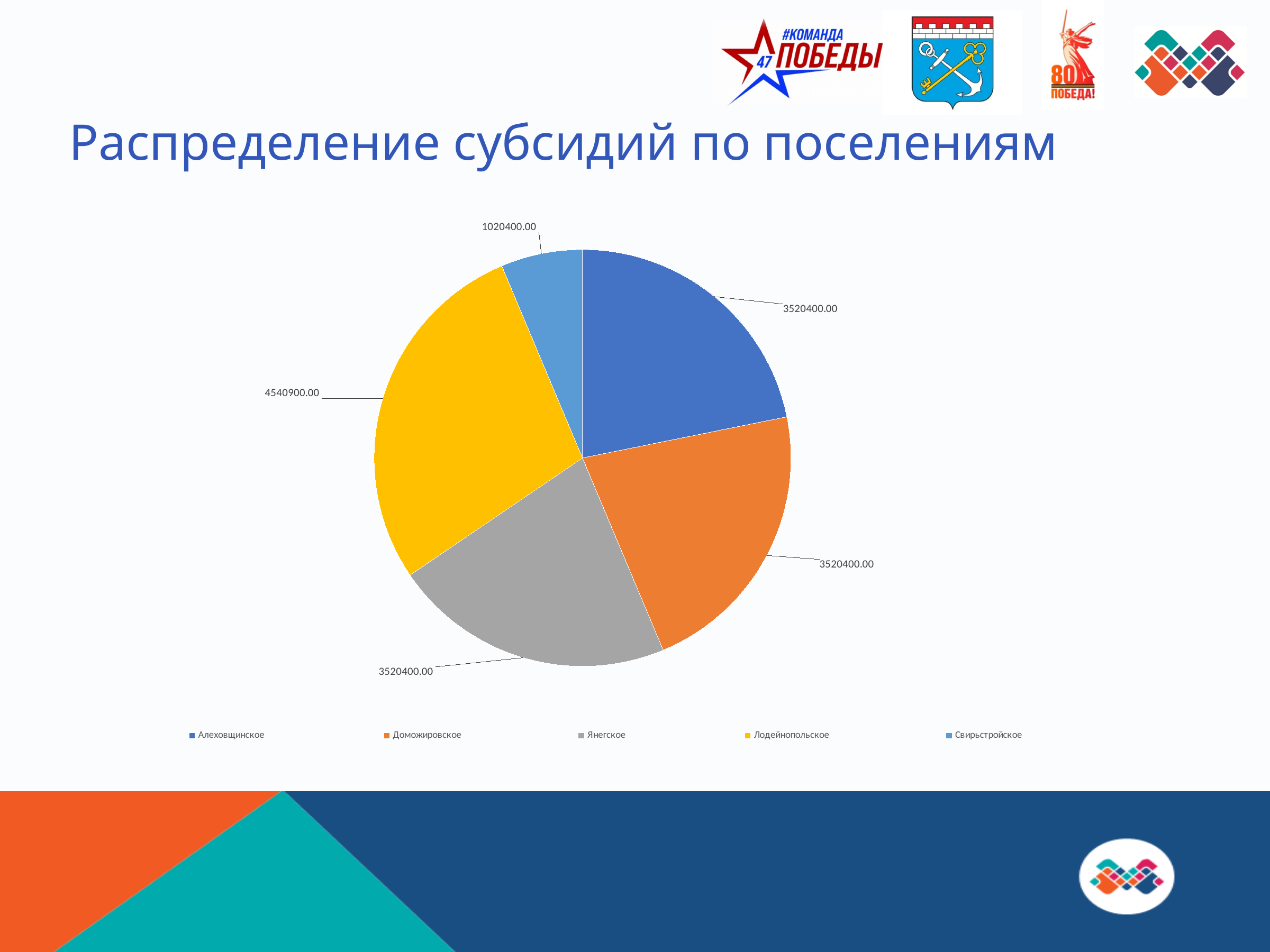
What is the value for Лодейнопольское? 4540900.00 What is the value for Свирьстройское? 1020400.00 What type of chart is shown on the slide? Pie chart Which settlement has the smallest slice of the pie? Свирьстройское What is the value for Алеховщинское? 3520400.00 Which is larger, the value for Лодейнопольское or the value for Алеховщинское? Лодейнопольское What is the value for Янегское? 3520400.00 What is the title of the chart on the slide? Распределение субсидий по поселениям How many slices does the pie chart have? 5 What is the difference between the values for Лодейнопольское and Доможировское? 1020500.00 What is the difference between the values for Лодейнопольское and Свирьстройское? 3520500.00 Which settlement has the largest slice of the pie? Лодейнопольское